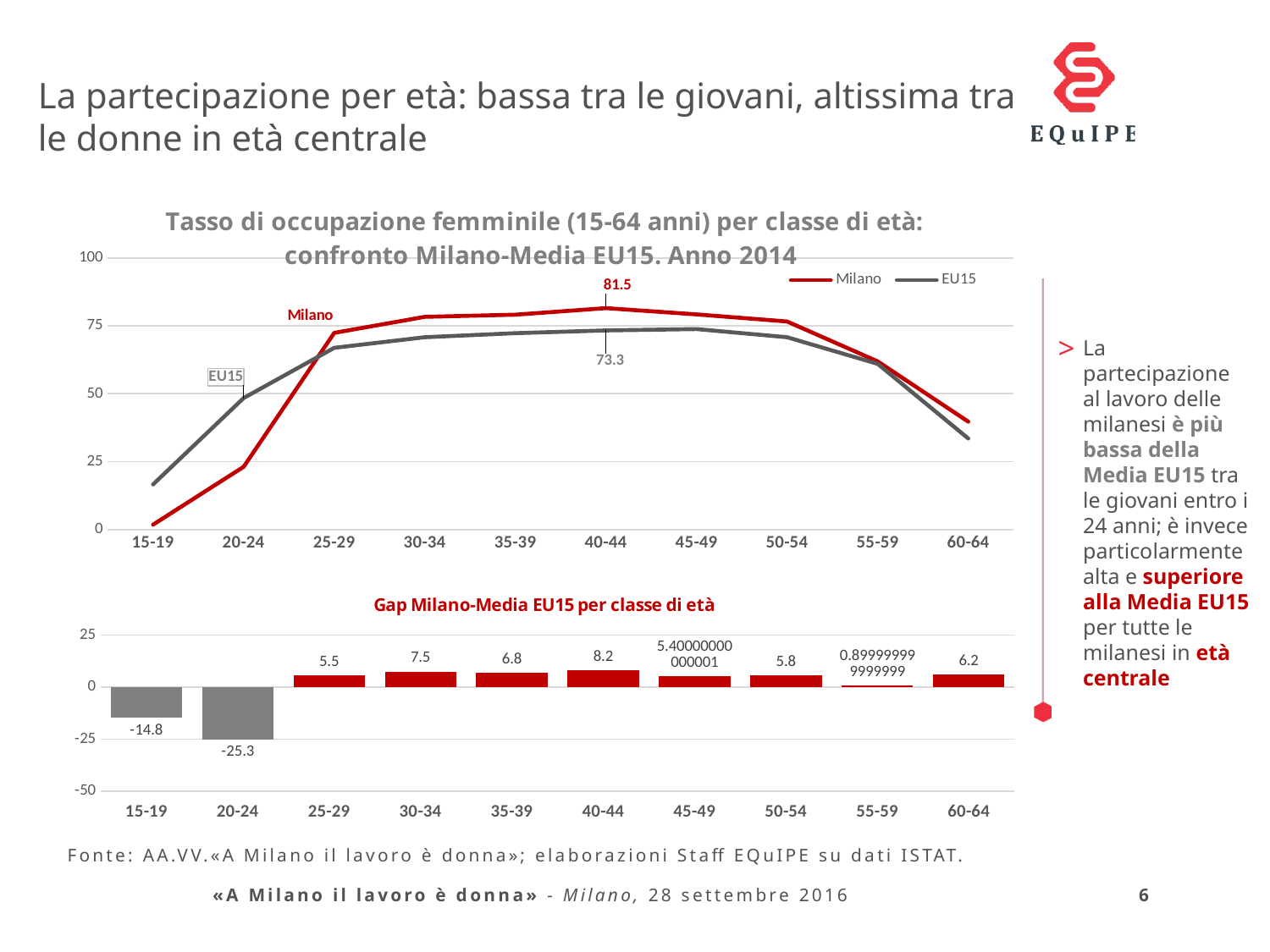
In the top chart 'Tasso di occupazione femminile', what is the value for EU15 in the 40-44 age class? 73.3 What kind of chart is the top chart 'Tasso di occupazione femminile'? line chart In the top chart 'Tasso di occupazione femminile', what is the difference between the Milano and EU15 values in the 40-44 age class? 8.2 In the bottom chart 'Gap Milano-Media EU15 per classe di età', what is the value for the 20-24 age class? -25.3 In the bottom chart 'Gap Milano-Media EU15 per classe di età', what is the difference between the values for 30-34 and 25-29? 2.0 In the bottom chart 'Gap Milano-Media EU15 per classe di età', which age class has the highest value? 40-44 In the top chart 'Tasso di occupazione femminile', is the Milano value for the 15-19 age class greater or less than 25? less In the bottom chart 'Gap Milano-Media EU15 per classe di età', how many age classes are shown on the x axis? 10 In the bottom chart 'Gap Milano-Media EU15 per classe di età', which age class has the lowest value? 20-24 In the top chart 'Tasso di occupazione femminile', what is the value for Milano in the 40-44 age class? 81.5 In the top chart 'Tasso di occupazione femminile', how many series does the legend list? 2 In the top chart 'Tasso di occupazione femminile', which series has the higher value in the 20-24 age class, Milano or EU15? EU15